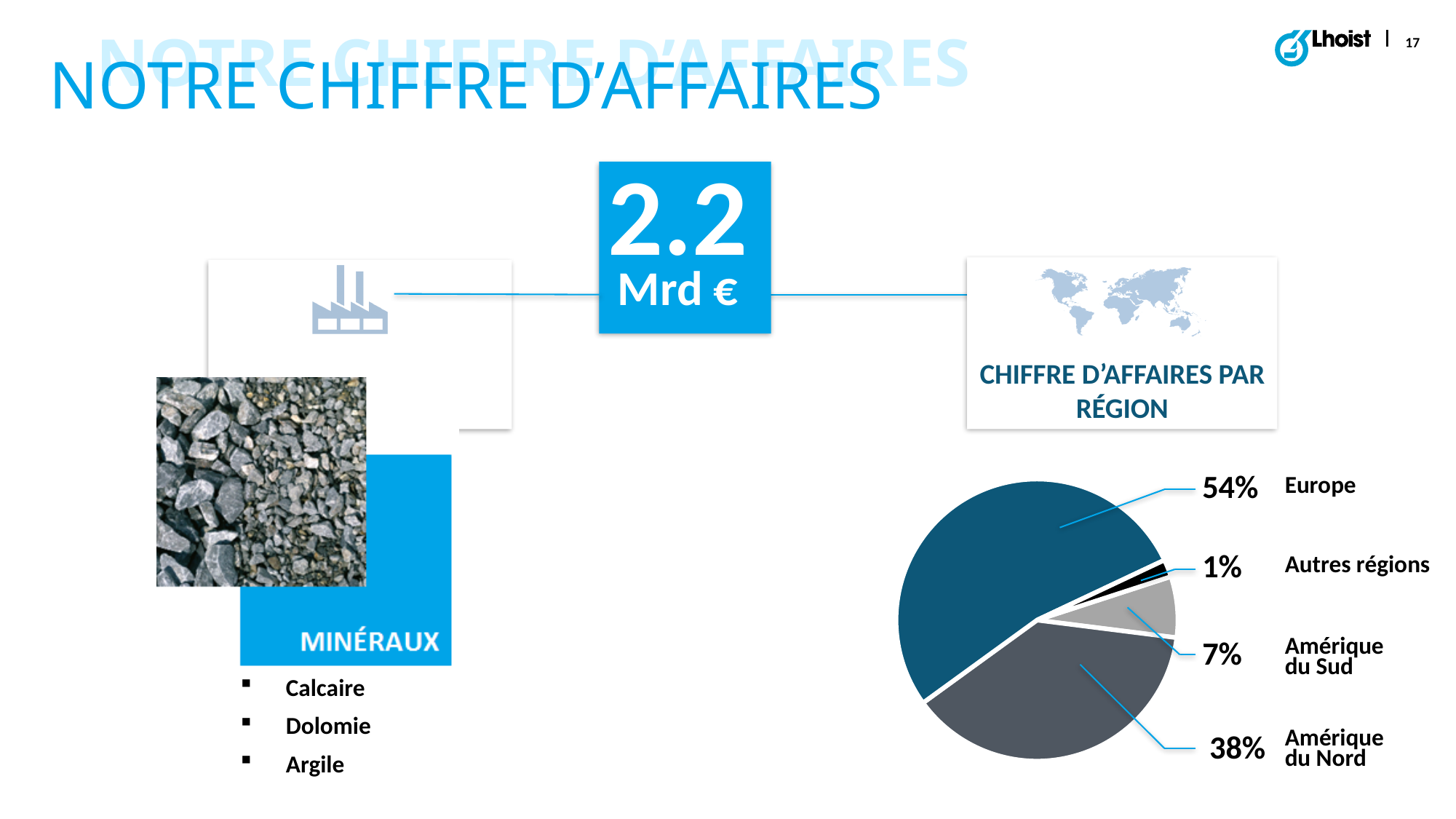
What share of revenue does Amérique du Sud account for in the pie chart? 7% What is the combined share of Europe and Amérique du Nord in the pie chart? 92% What kind of chart is used to show the revenue by region (Chiffre d'affaires par région)? pie chart Which has a larger share in the pie chart, Amérique du Sud or Autres régions? Amérique du Sud How many regions are shown in the pie chart? 4 What is the title of the pie chart? Chiffre d'affaires par région Which region has the smallest share in the pie chart? Autres régions Which region has the largest share in the pie chart? Europe What share of revenue does Europe account for in the pie chart? 54% What share of revenue does Amérique du Nord account for in the pie chart? 38% What share of revenue do Autres régions account for in the pie chart? 1% What is the difference in percentage points between Europe and Amérique du Nord in the pie chart? 16